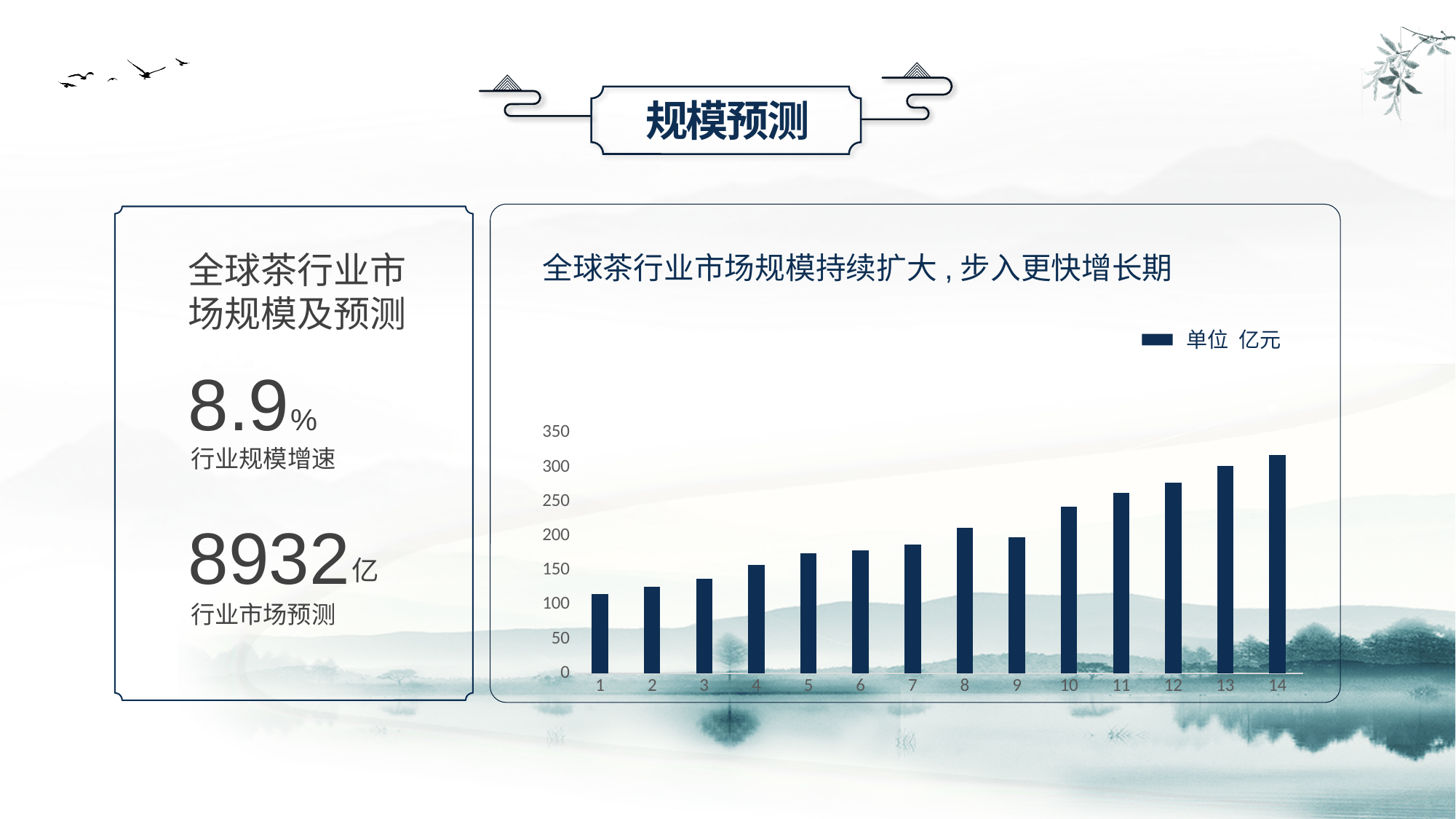
Which has the larger value, category 8 or category 9? category 8 How many categories are plotted along the x axis of the chart? 14 Do the bar values generally rise or fall from category 1 to category 14? rise What text does the chart's legend entry show? 单位 亿元 Is the value for category 12 greater or less than 250? greater How many series does the chart's legend list? 1 Is the value for category 10 greater or less than 200? greater Which category has the lowest bar in the chart? 1 Is the value for category 1 greater or less than 150? less Which category has the highest bar in the chart? 14 What kind of chart is shown on the slide? bar chart